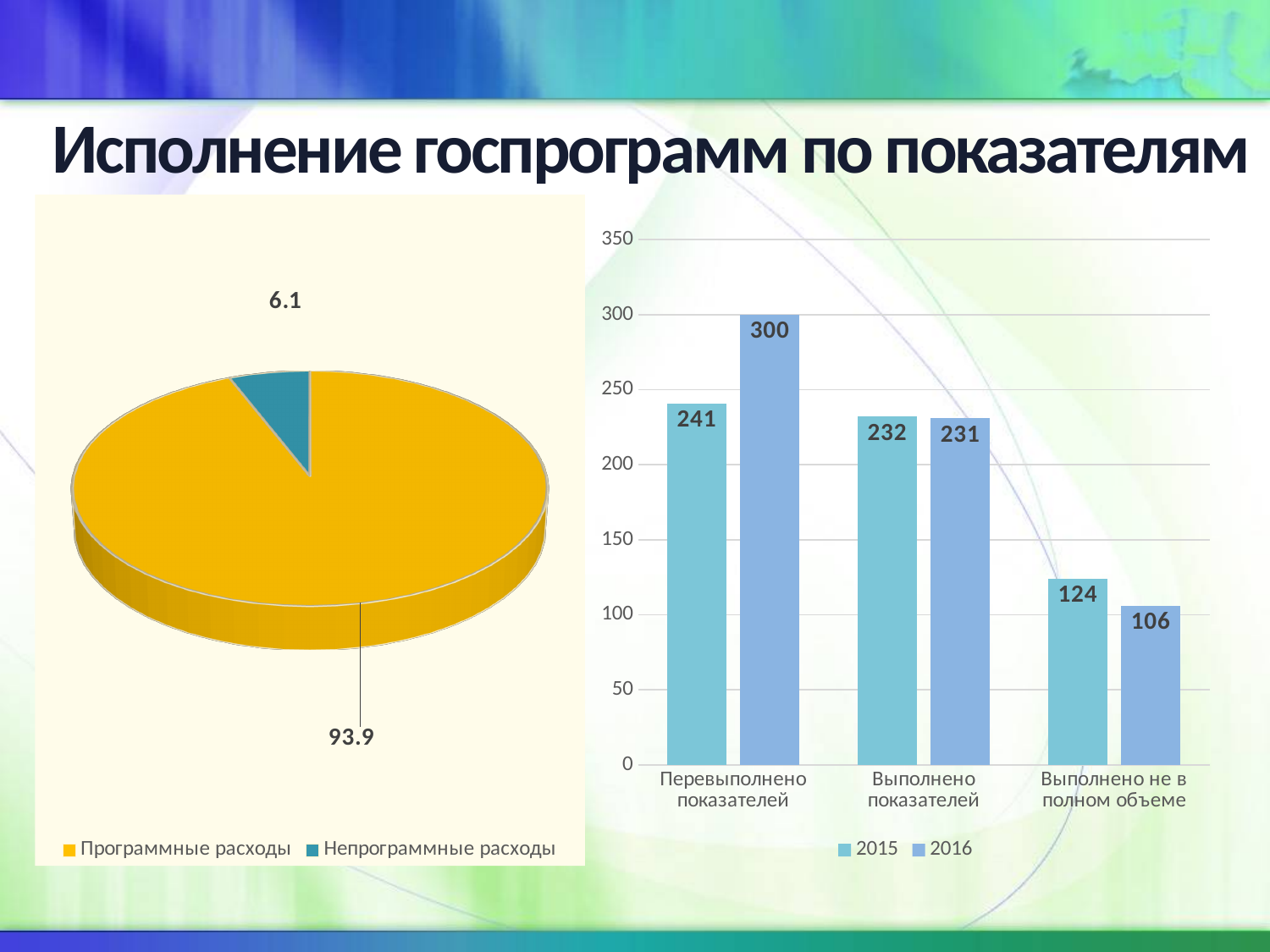
In the bar chart on the right, which is larger for Выполнено не в полном объеме: the 2015 value or the 2016 value? 2015 What kind of chart is the chart on the right? bar chart How many series does the legend of the bar chart on the right list? 2 In the bar chart on the right, which category has the lowest 2016 value? Выполнено не в полном объеме In the pie chart on the left, what is the value for Непрограммные расходы? 6.1 In the bar chart on the right, what is the 2016 value for Перевыполнено показателей? 300 How many categories are shown on the x axis of the bar chart on the right? 3 In the pie chart on the left, which slice is the largest? Программные расходы In the bar chart on the right, what is the difference between the 2016 and 2015 values for Перевыполнено показателей? 59 What kind of chart is the chart on the left? pie chart In the pie chart on the left, what is the value for Программные расходы? 93.9 In the bar chart on the right, what is the 2015 value for Выполнено не в полном объеме? 124